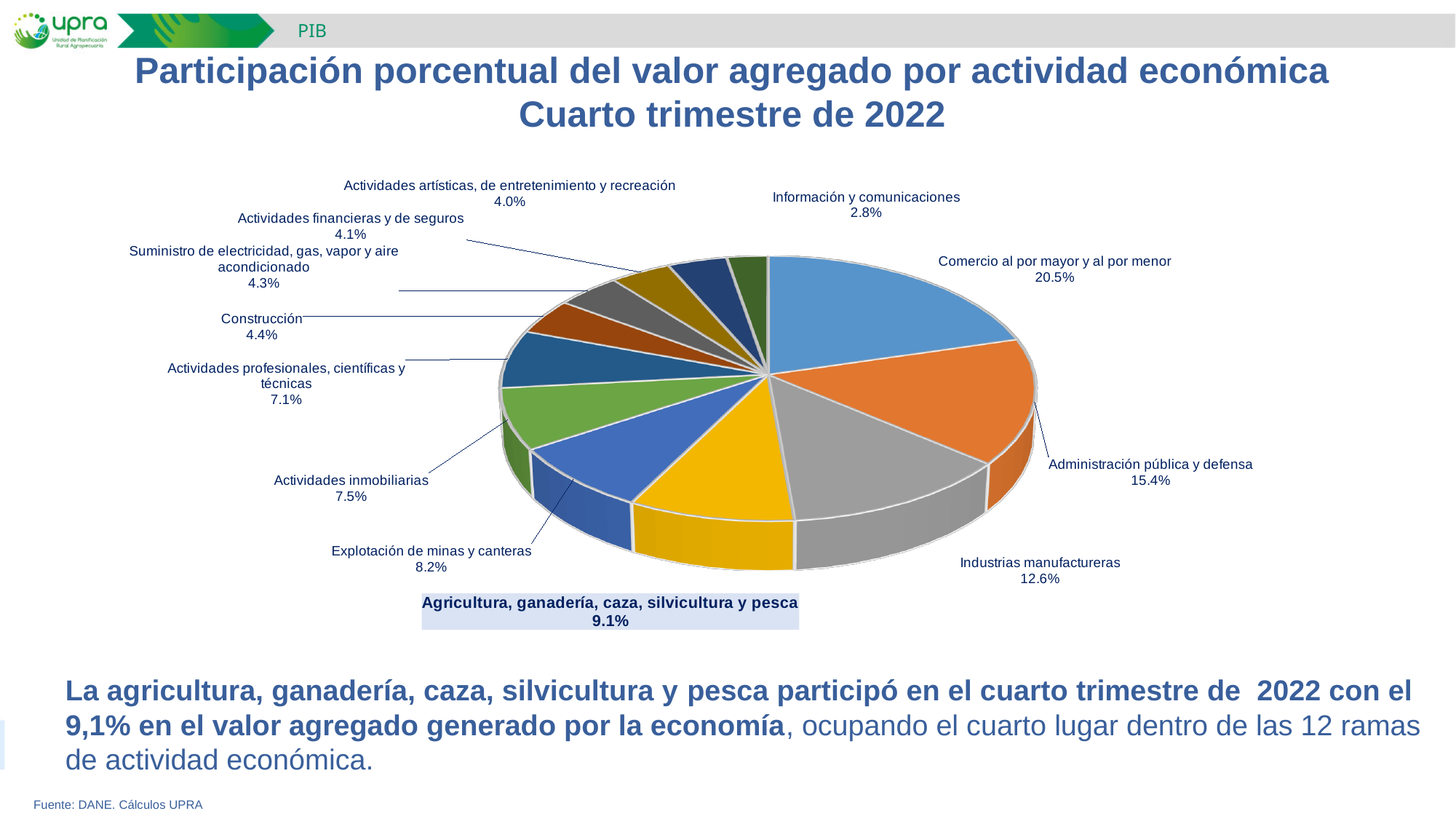
Which has a larger share, Explotación de minas y canteras or Actividades inmobiliarias? Explotación de minas y canteras Which activity has the smallest share of the pie? Información y comunicaciones What is the difference in percentage points between Comercio al por mayor y al por menor and Administración pública y defensa? 5.1 How many activities (slices) are shown in the pie chart? 12 What is the combined share of Actividades inmobiliarias and Actividades profesionales, científicas y técnicas? 14.6% Which activity has the largest share of the pie? Comercio al por mayor y al por menor What is the share of Comercio al por mayor y al por menor? 20.5% What period does the chart title refer to? Cuarto trimestre de 2022 What kind of chart is shown on the slide? pie chart What is the share of Agricultura, ganadería, caza, silvicultura y pesca? 9.1% What is the share of Información y comunicaciones? 2.8% What is the share of Industrias manufactureras? 12.6%